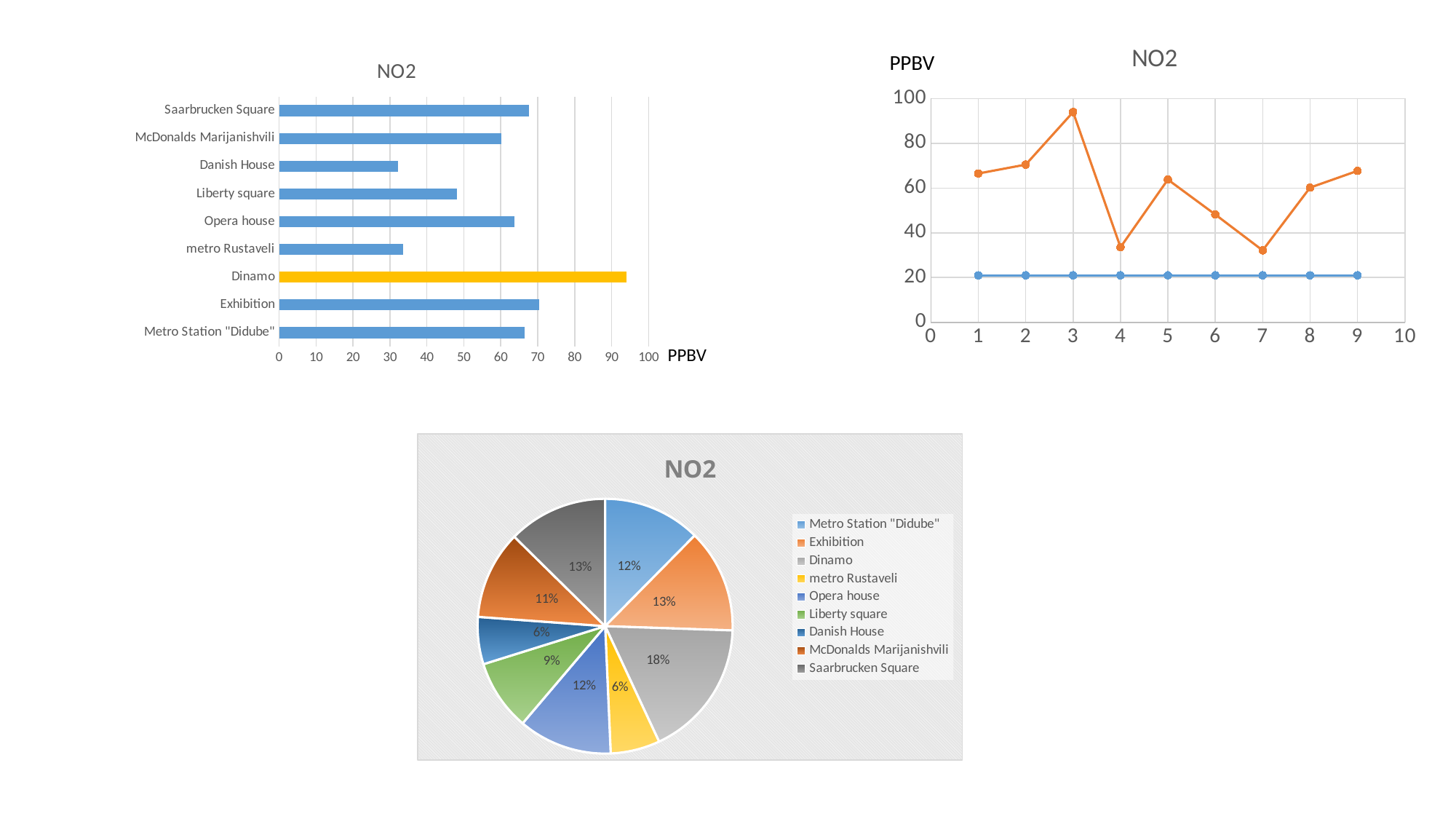
In the top-left bar chart, is the value for Dinamo greater or less than 90? greater In the top-left bar chart, which location has the highest NO2 value? Dinamo In the top-left bar chart, is the value for Danish House greater or less than 40? less In the bottom pie chart, what share does Liberty square have? 9% In the bottom pie chart, what share does Dinamo have? 18% In the top-right line chart, is the orange line's value at x = 7 greater or less than 40? less How many locations are shown in the top-left bar chart? 9 In the top-left bar chart, which is larger, the value for Exhibition or the value for Liberty square? Exhibition In the bottom pie chart, what is the difference between the shares of Dinamo and McDonalds Marijanishvili? 7% What type of chart is the top-right chart on the slide? line chart What type of chart is the top-left chart on the slide? bar chart In the top-right line chart, at which x value does the orange line reach its highest point? 3